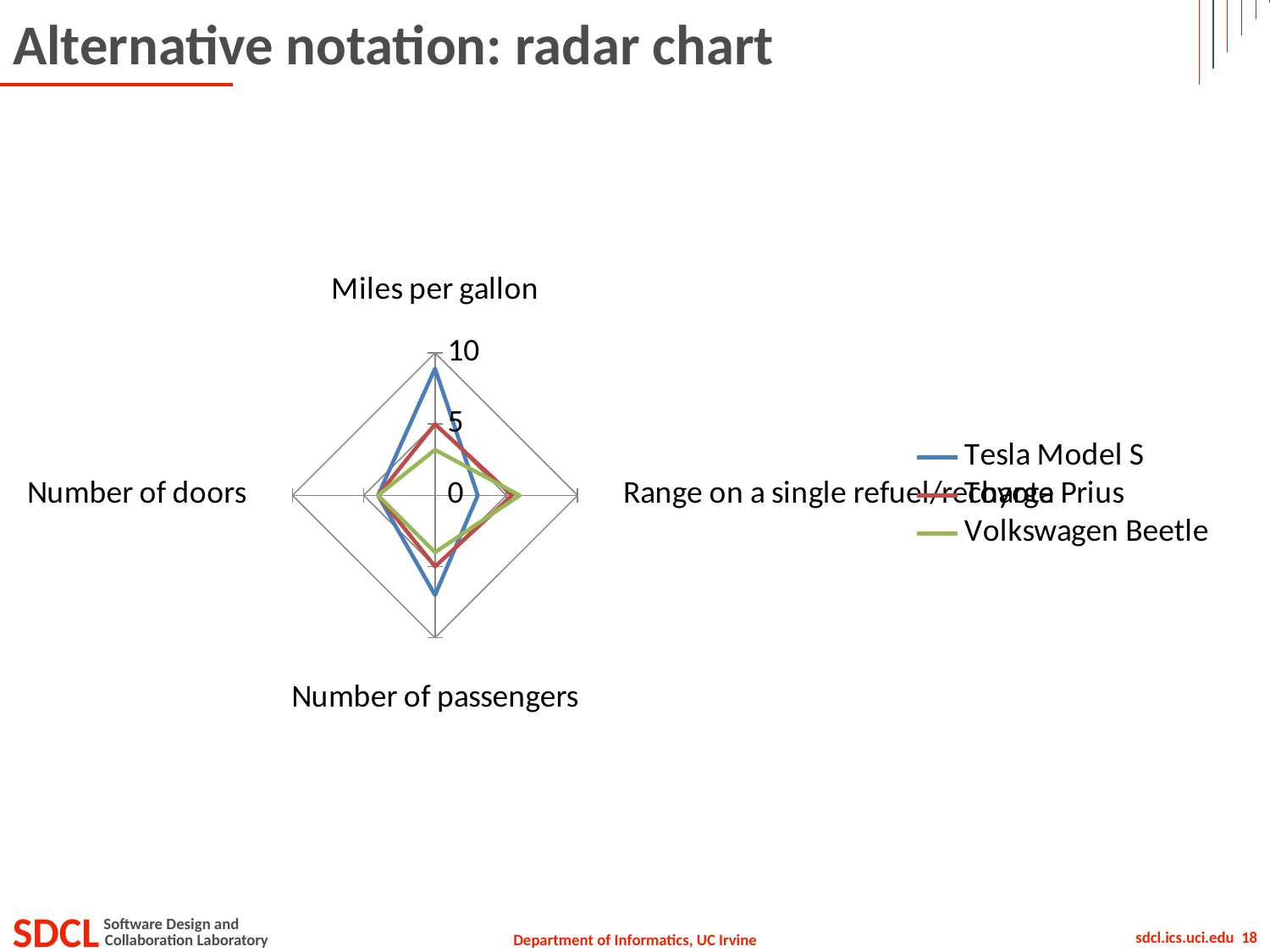
Which has the larger Miles per gallon value, Tesla Model S or Volkswagen Beetle? Tesla Model S How many axes (categories) does the radar chart have? 4 What is the maximum value shown on the radar chart's axis scale? 10 Which series has the highest value for Miles per gallon? Tesla Model S Which series has the lowest value for Miles per gallon? Volkswagen Beetle Which series has the highest value for Range on a single refuel/recharge? Volkswagen Beetle How many series does the legend list? 3 What kind of chart is shown on the slide? radar chart Is the Miles per gallon value for Volkswagen Beetle greater or less than 5? less Is the Number of passengers value for Tesla Model S greater or less than 5? greater Which series has the highest value for Number of passengers? Tesla Model S Is the Miles per gallon value for Tesla Model S greater or less than 5? greater